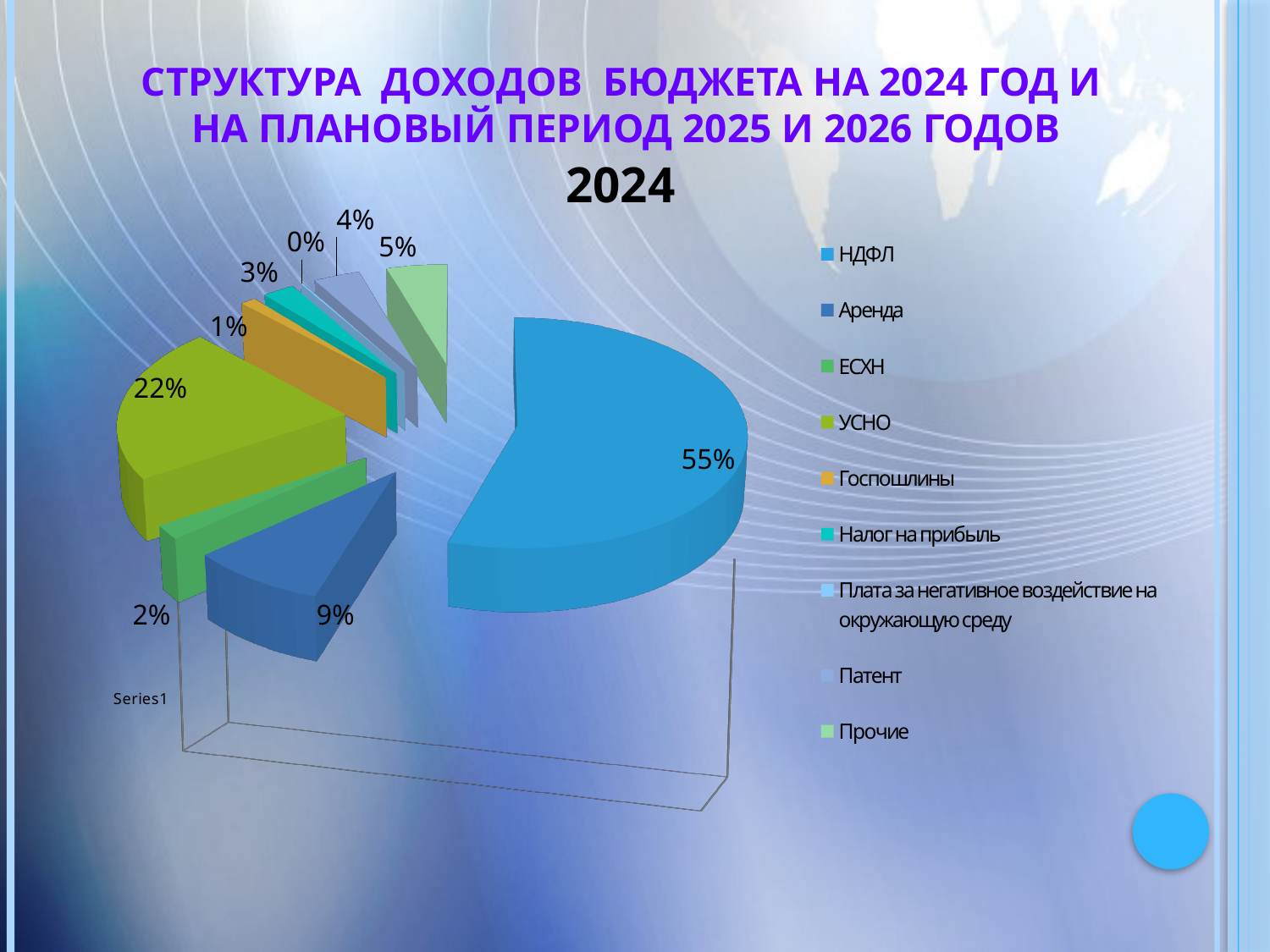
Which category has the largest share of the pie? НДФЛ How many entries does the legend of the pie chart list? 9 What share of the pie does Аренда have? 9% What is the title shown above the pie chart? 2024 What type of chart is shown on the slide? pie chart What share of the pie does НДФЛ have? 55% What share of the pie does УСНО have? 22% What is the difference between the share for НДФЛ and the share for УСНО? 33% Which is larger, the share for УСНО or the share for Аренда? УСНО What colour is the slice for НДФЛ? blue